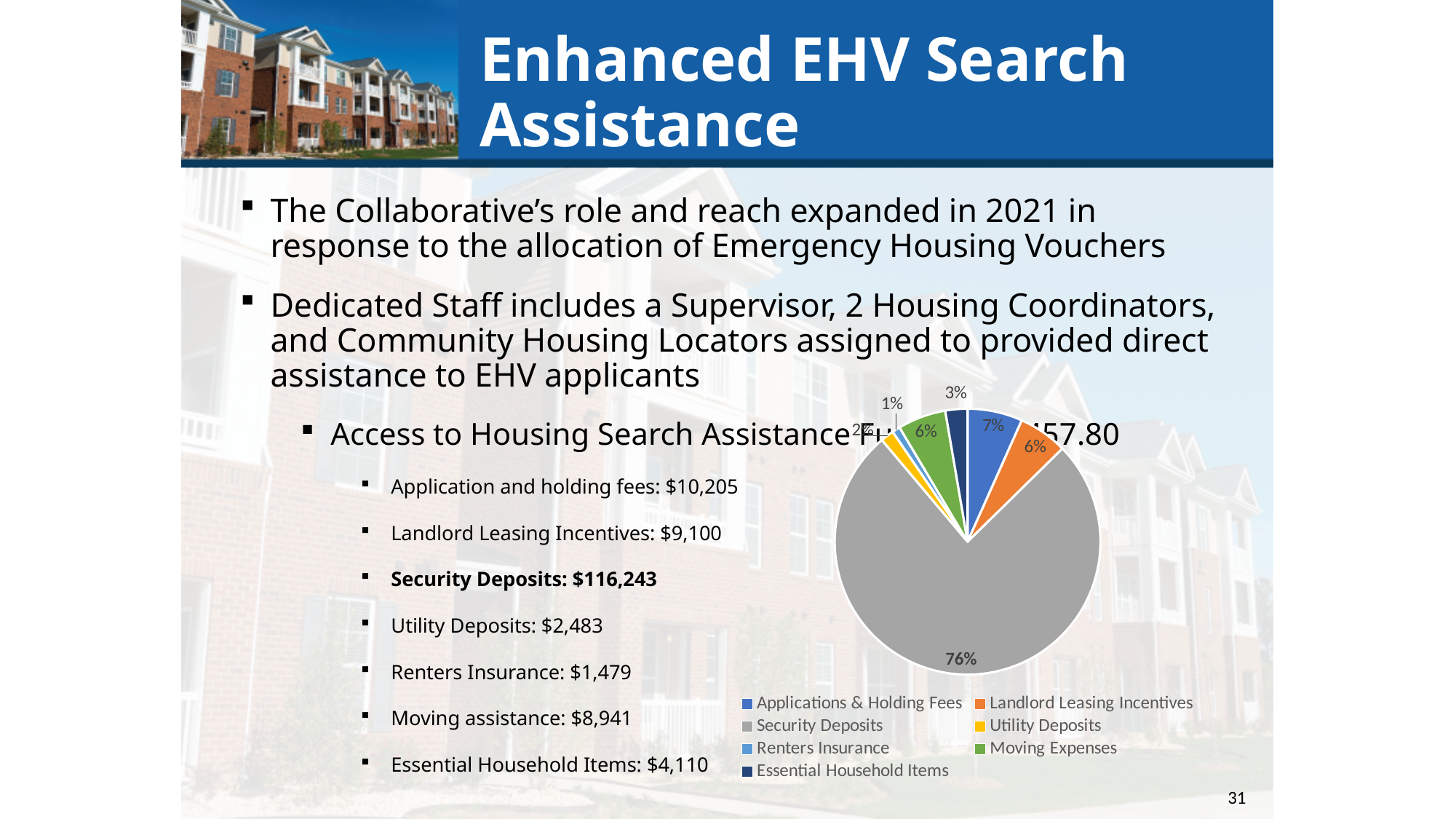
Which category has the largest slice of the pie chart? Security Deposits Which category has the smallest slice of the pie chart? Renters Insurance What share of the pie chart does Applications & Holding Fees represent? 7% What share of the pie chart does Renters Insurance represent? 1% How many categories does the pie chart's legend list? 7 What kind of chart is shown on the slide? pie chart What colour is the Security Deposits slice in the pie chart? gray Which slice is larger in the pie chart: Applications & Holding Fees or Essential Household Items? Applications & Holding Fees What share of the pie chart does Moving Expenses represent? 6%